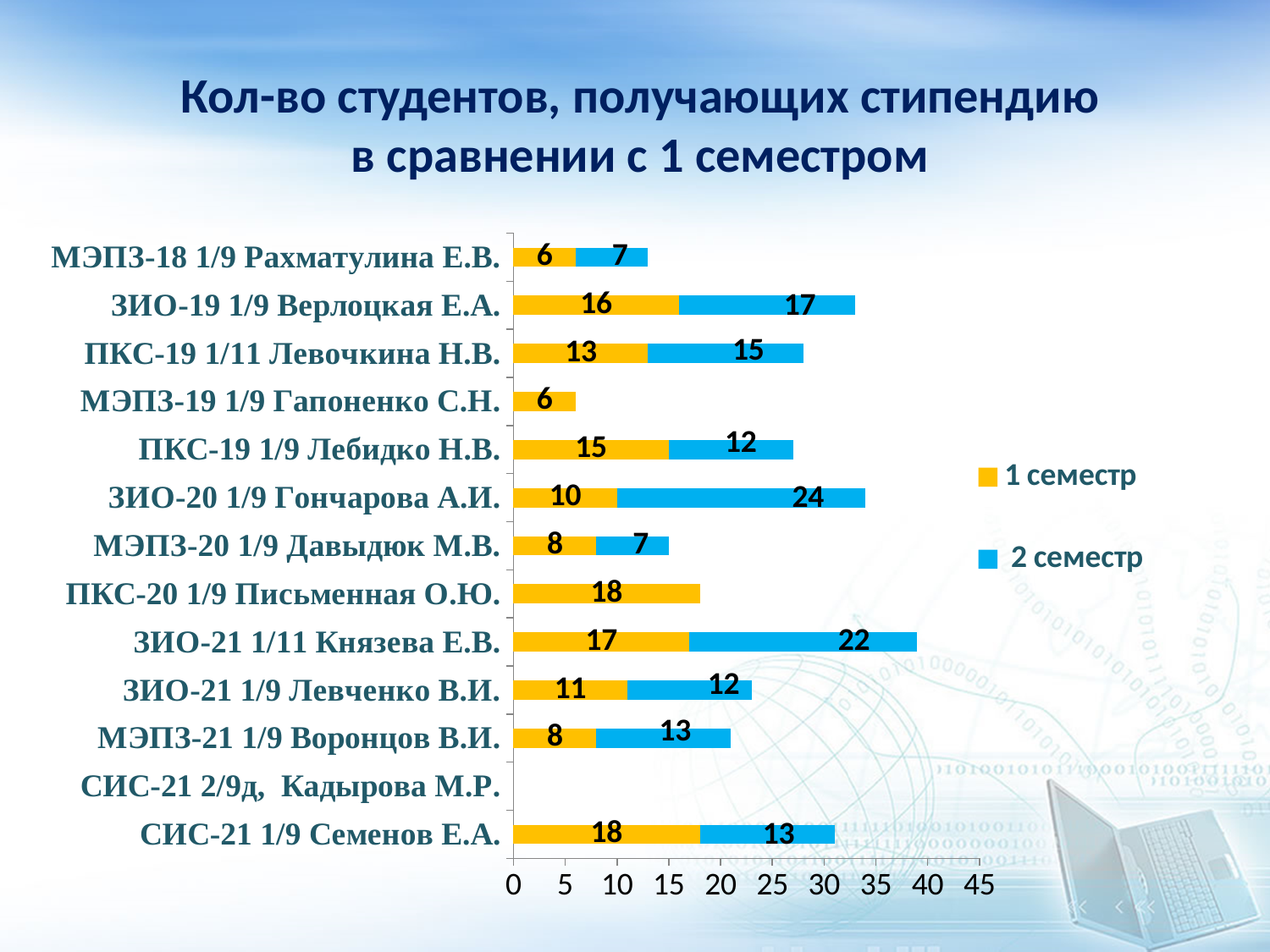
Which is larger for ПКС-19 1/9 Лебидко Н.В.: the 1 семестр value or the 2 семестр value? 1 семестр What is the total of the stacked bar for ЗИО-21 1/11 Князева Е.В.? 39 Which colour represents 2 семестр in the legend? blue How many series does the legend list? 2 What is the difference between the 2 семестр and 1 семестр values for ЗИО-20 1/9 Гончарова А.И.? 14 What is the value for 1 семестр for ЗИО-20 1/9 Гончарова А.И.? 10 What kind of chart is shown on the slide? stacked bar chart What is the value for 2 семестр for ЗИО-21 1/11 Князева Е.В.? 22 What is the total of the stacked bar for ЗИО-19 1/9 Верлоцкая Е.А.? 33 Which category has the highest value for 2 семестр? ЗИО-20 1/9 Гончарова А.И. How many categories are listed on the vertical axis? 13 What is the value for 1 семестр for ПКС-20 1/9 Письменная О.Ю.? 18